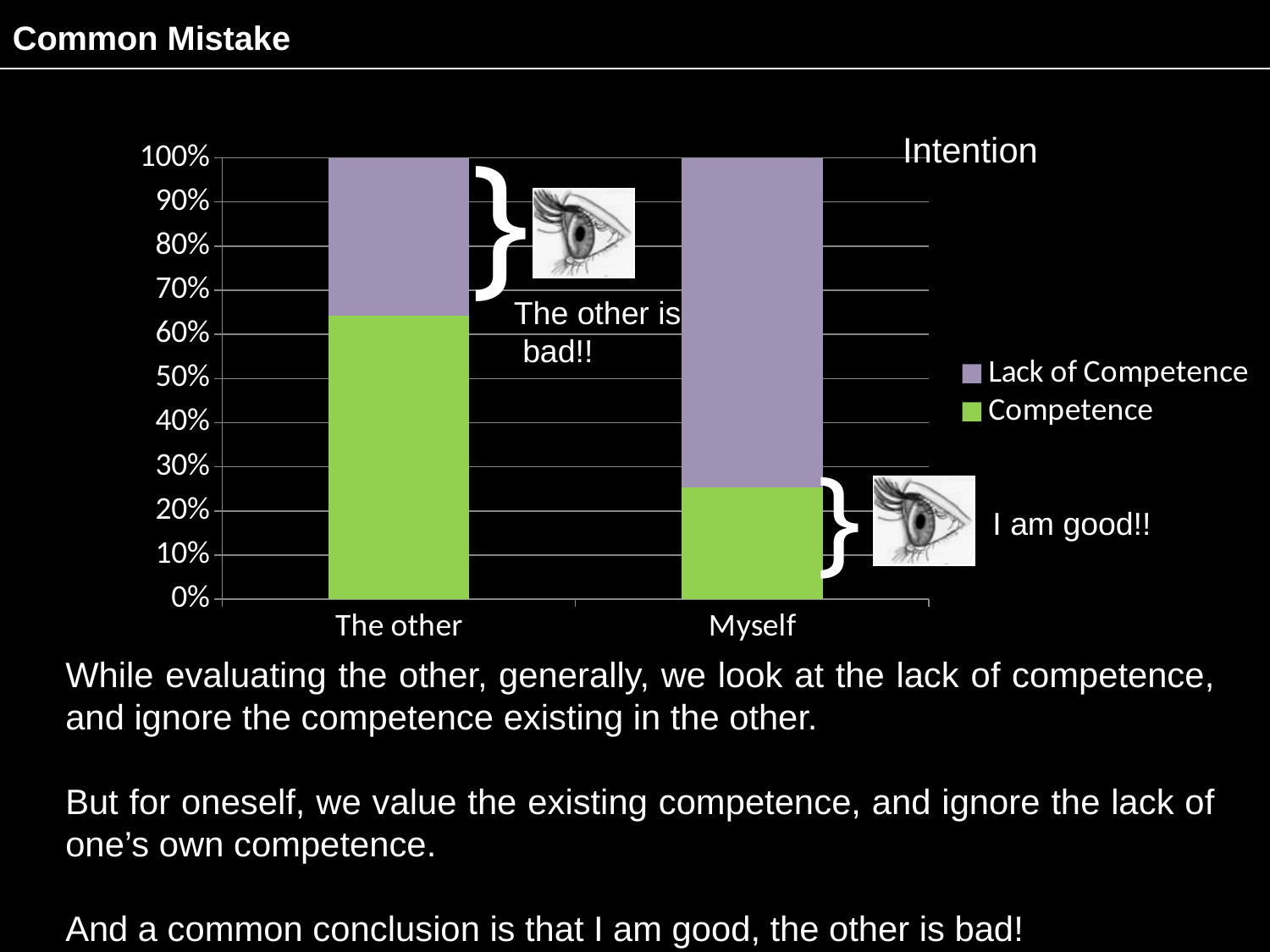
Which category has the larger Lack of Competence share, The other or Myself? Myself Is the Competence value for Myself greater or less than 30%? less How many series does the chart legend list? 2 Which category has the larger Competence share, The other or Myself? The other What kind of chart is shown on the slide? Stacked bar chart Is the Competence value for The other greater or less than 50%? greater Is the Competence value for Myself greater or less than 20%? greater How many categories are shown on the x axis of the chart? 2 Which series does the green colour represent in the chart? Competence Which series does the purple colour represent in the chart? Lack of Competence What is the total height of the stacked bar for Myself? 100%